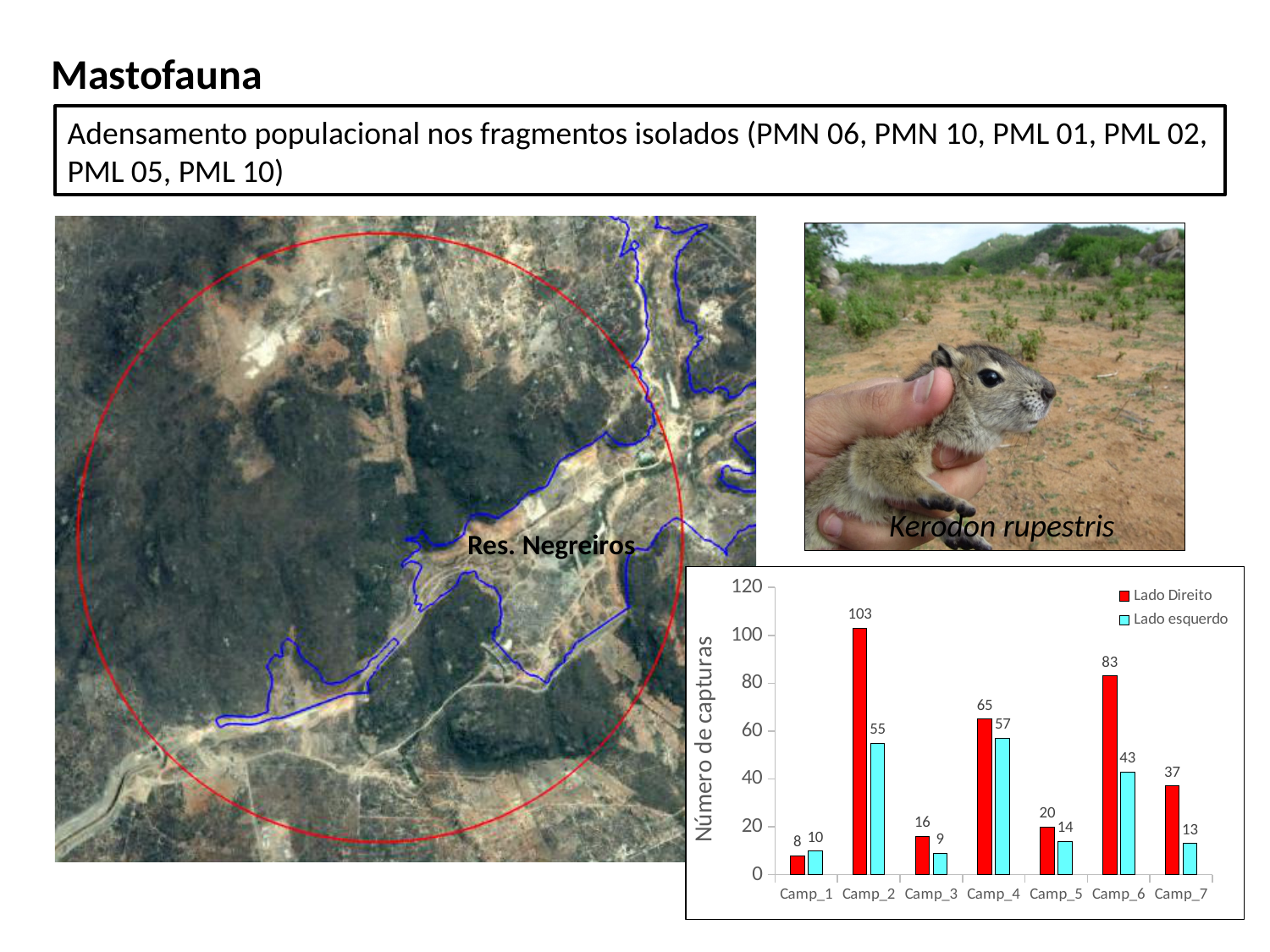
What is the value for Lado esquerdo at Camp_4? 57 What is the value for Lado Direito at Camp_2? 103 What is the label of the y axis of the chart? Número de capturas At Camp_1, which is larger: Lado Direito or Lado esquerdo? Lado esquerdo What kind of chart is shown on the slide? bar chart Which campaign has the lowest value for Lado esquerdo? Camp_3 Is the value for Lado Direito at Camp_6 greater or less than 80? greater What is the value for Lado esquerdo at Camp_7? 13 Which campaign has the highest value for Lado Direito? Camp_2 How many campaigns are shown on the x axis? 7 What is the difference between Lado Direito and Lado esquerdo at Camp_6? 40 How many series does the legend list? 2